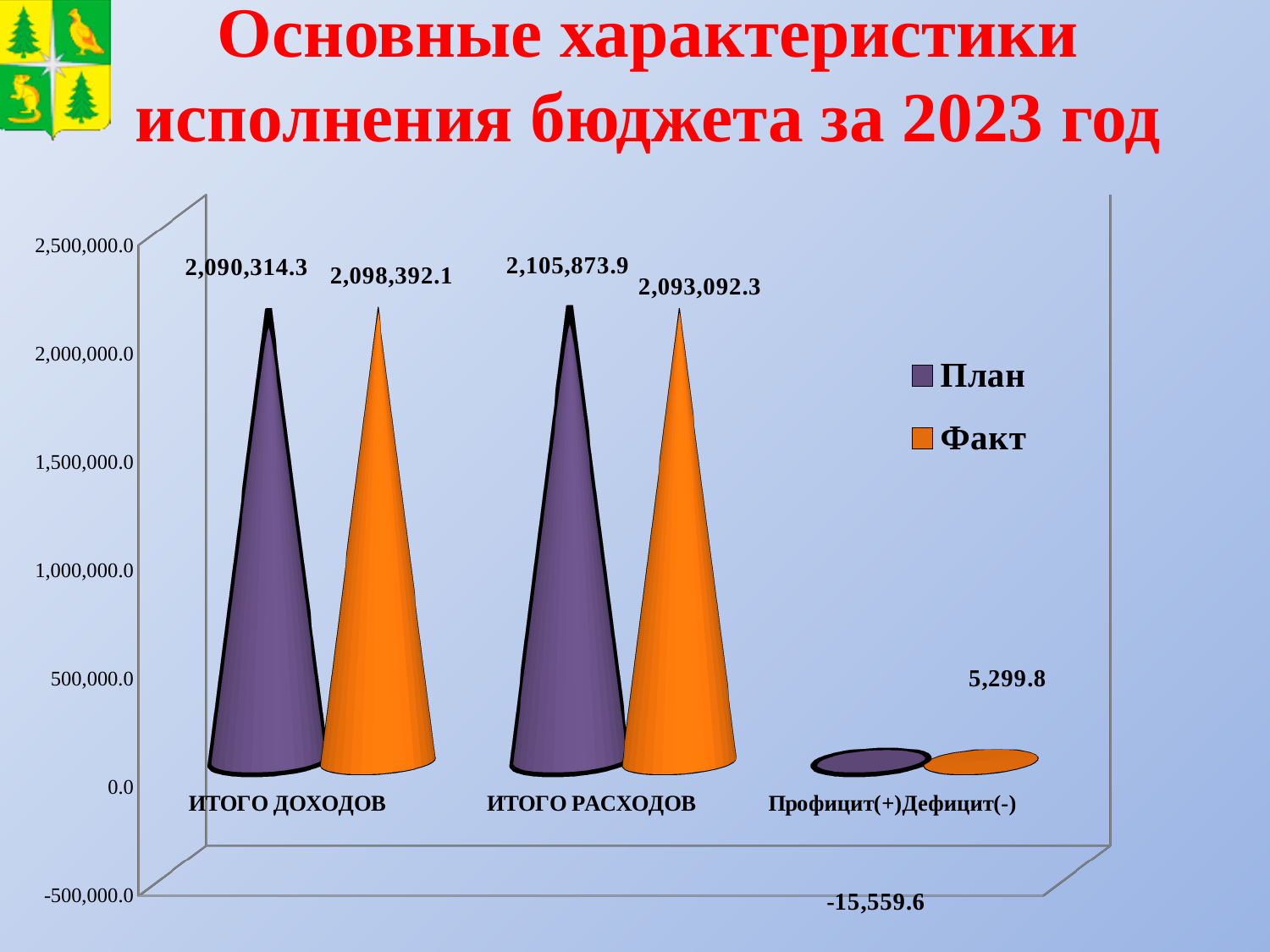
What is the Факт value for ИТОГО ДОХОДОВ? 2,098,392.1 How many categories are shown on the x axis? 3 What is the План value for ИТОГО ДОХОДОВ? 2,090,314.3 What is the План value for ИТОГО РАСХОДОВ? 2,105,873.9 Which colour represents the Факт series? Orange For ИТОГО РАСХОДОВ, which is larger: the План value or the Факт value? План What is the План value for Профицит(+)Дефицит(-)? -15,559.6 What is the Факт value for ИТОГО РАСХОДОВ? 2,093,092.3 How many series does the legend list? 2 What is the difference between the Факт and План values for ИТОГО ДОХОДОВ? 8,077.8 Which category has the lowest Факт value? Профицит(+)Дефицит(-) What is the Факт value for Профицит(+)Дефицит(-)? 5,299.8